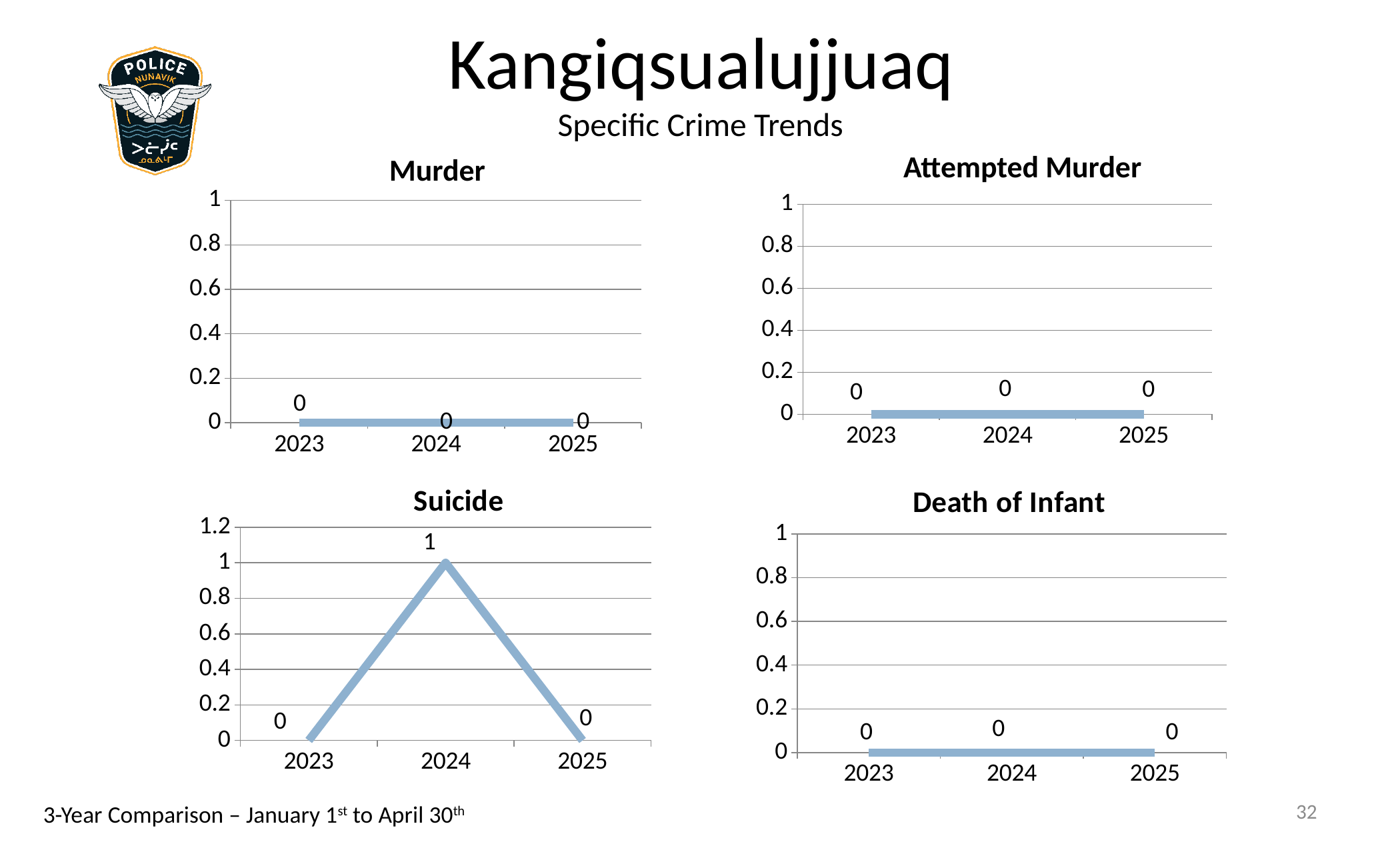
In the Suicide chart, which is larger, the value for 2024 or the value for 2023? 2024 What is the title of the chart in the bottom right of the slide? Death of Infant What kind of chart is the Suicide chart? line chart In the Suicide chart, what is the difference between the 2024 value and the 2025 value? 1 In the Murder chart, what is the value for 2025? 0 In the Attempted Murder chart, what is the value for 2024? 0 In the Suicide chart, what is the value for 2023? 0 In the Suicide chart, does the value rise or fall from 2024 to 2025? fall In the Suicide chart, what is the value for 2024? 1 In the Suicide chart, which year has the highest value? 2024 In the Death of Infant chart, what is the value for 2023? 0 How many data points are plotted in the Suicide chart? 3